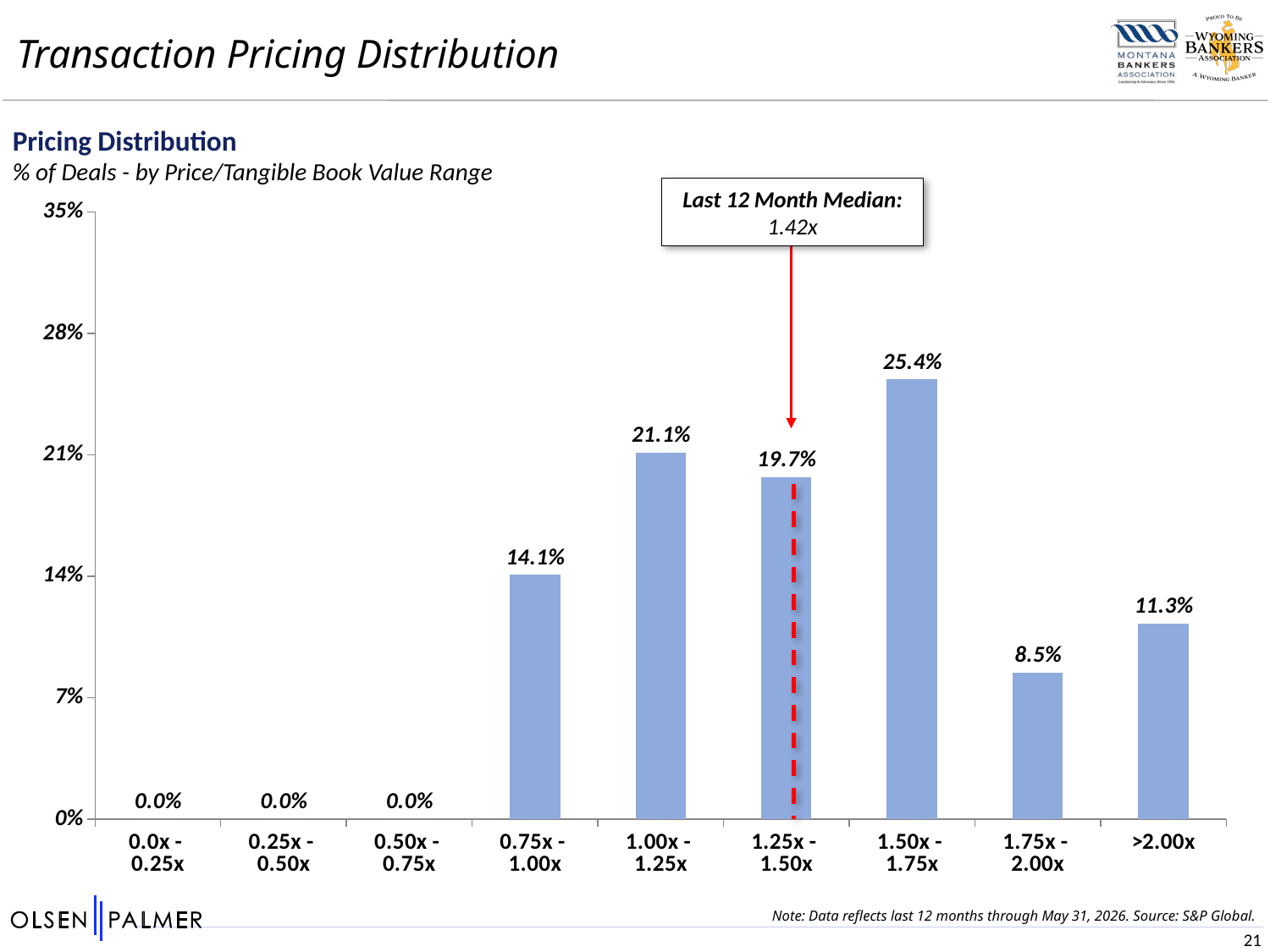
What is the difference in percentage of deals between the 1.00x - 1.25x range and the 1.25x - 1.50x range? 1.4% What percentage of deals fall in the >2.00x range? 11.3% What is the Last 12 Month Median price/tangible book value shown in the callout? 1.42x How many ranges show 0.0% of deals? 3 What is the total percentage of deals in the 1.25x - 1.50x and 1.50x - 1.75x ranges combined? 45.1% What kind of chart is shown on the slide? Bar chart What percentage of deals fall in the 0.75x - 1.00x range? 14.1% How many price/tangible book value ranges are shown on the x axis? 9 Which price/tangible book value range has the highest percentage of deals? 1.50x - 1.75x What percentage of deals fall in the 1.50x - 1.75x price/tangible book value range? 25.4% Is the value for the 1.50x - 1.75x range greater or less than 21%? greater Which range has a larger share of deals: 1.75x - 2.00x or >2.00x? >2.00x